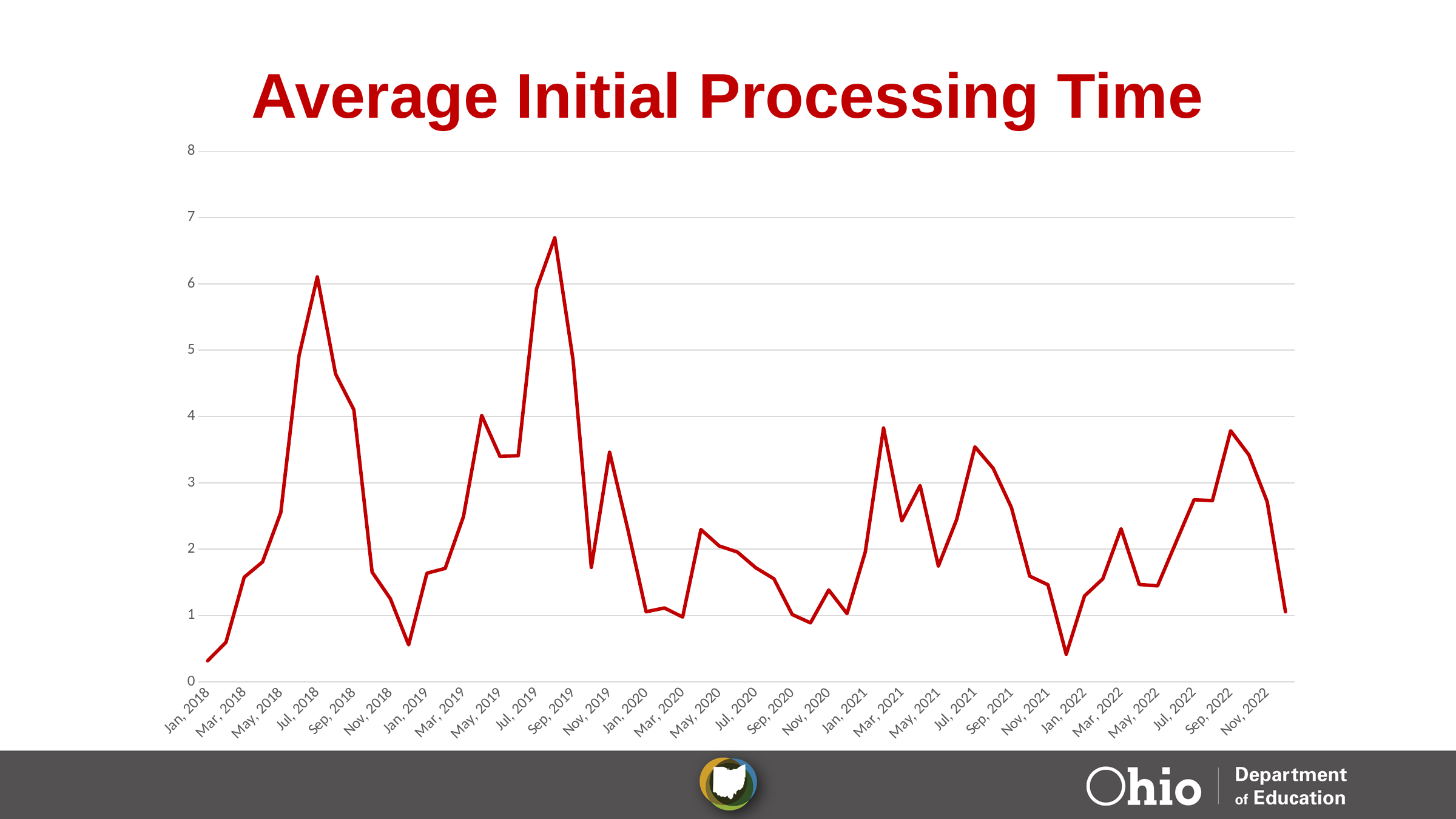
What kind of chart is shown on the slide? line chart Is the value for Jan, 2018 greater or less than 1? less In which year does the line reach its highest point? 2019 How many lines are plotted on the chart? 1 What is the highest value shown on the vertical axis? 8 Does the line rise or fall between Sep, 2022 and the final point on the chart? fall What is the title of the chart? Average Initial Processing Time Is the value for Sep, 2022 greater or less than 3? greater Is the value for Jan, 2020 greater or less than 2? less Which is larger, the value for Jul, 2018 or the value for Jul, 2021? Jul, 2018